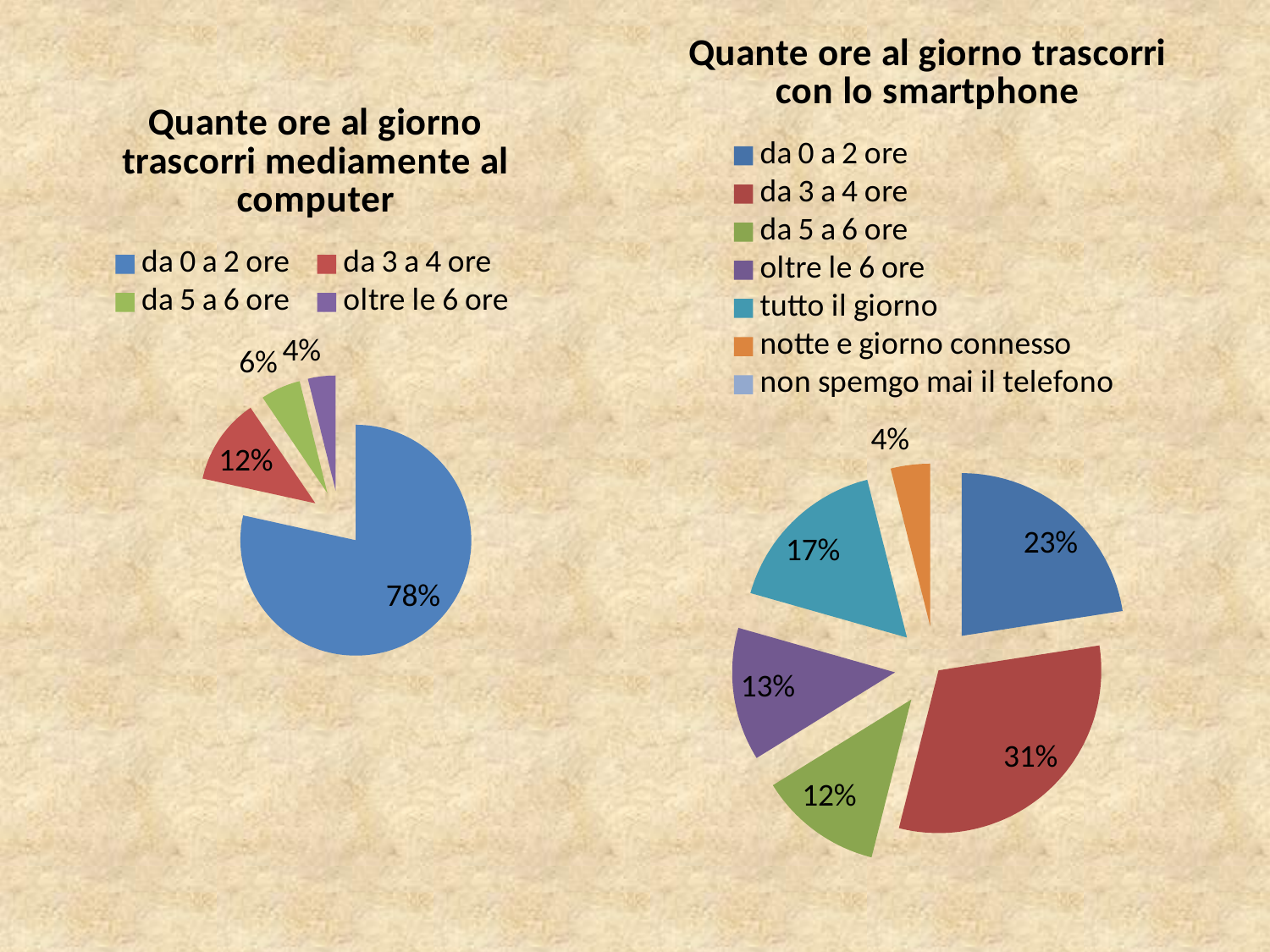
In the chart titled "Quante ore al giorno trascorri con lo smartphone", what percentage is shown for "tutto il giorno"? 17% In the chart titled "Quante ore al giorno trascorri mediamente al computer", which category has the smallest slice? oltre le 6 ore How many entries does the legend of the chart titled "Quante ore al giorno trascorri con lo smartphone" list? 7 In the chart titled "Quante ore al giorno trascorri con lo smartphone", what is the difference between "da 3 a 4 ore" and "da 0 a 2 ore"? 8% In the chart titled "Quante ore al giorno trascorri mediamente al computer", what percentage is shown for "da 0 a 2 ore"? 78% In the chart titled "Quante ore al giorno trascorri con lo smartphone", which category has the largest slice? da 3 a 4 ore In the chart titled "Quante ore al giorno trascorri con lo smartphone", what colour is the "notte e giorno connesso" slice? orange In the chart titled "Quante ore al giorno trascorri mediamente al computer", what percentage is shown for "da 3 a 4 ore"? 12% In the chart titled "Quante ore al giorno trascorri mediamente al computer", what is the difference between the "da 5 a 6 ore" and "oltre le 6 ore" slices? 2% In the chart titled "Quante ore al giorno trascorri con lo smartphone", which is larger: "da 0 a 2 ore" or "oltre le 6 ore"? da 0 a 2 ore In the chart titled "Quante ore al giorno trascorri con lo smartphone", what percentage is shown for "da 3 a 4 ore"? 31% What kind of chart is the one titled "Quante ore al giorno trascorri mediamente al computer"? pie chart